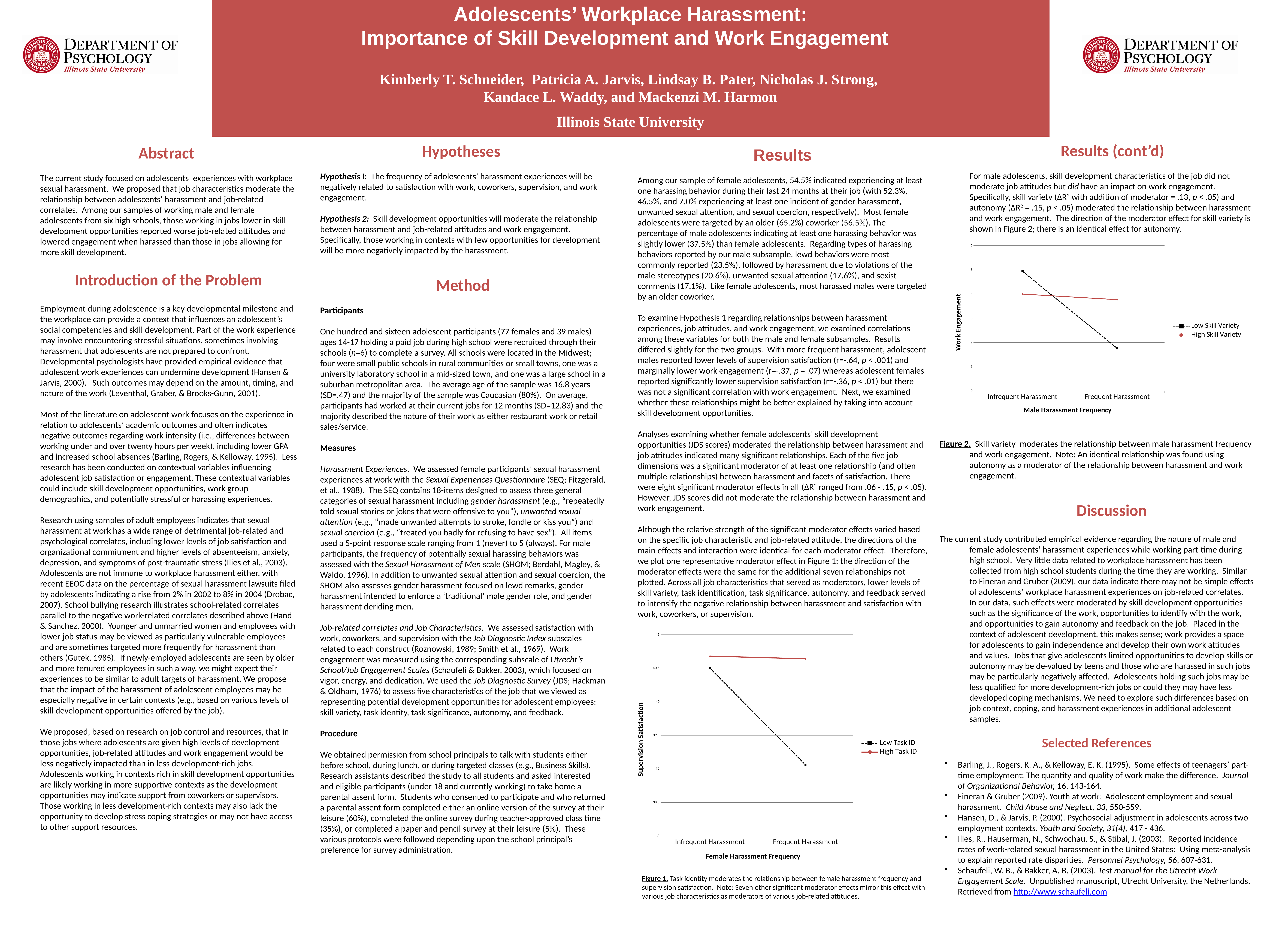
In Figure 1 (Supervision Satisfaction chart), which series has the higher value at Frequent Harassment, Low Task ID or High Task ID? High Task ID In Figure 1 (Supervision Satisfaction chart), is the Low Task ID value at Frequent Harassment greater or less than 39.5? less In Figure 2 (Work Engagement chart), which series has the higher value at Infrequent Harassment, Low Skill Variety or High Skill Variety? Low Skill Variety In Figure 1 (Supervision Satisfaction chart), how many categories are on the x axis? 2 In Figure 2 (Work Engagement chart), how many series does the legend list? 2 In Figure 2 (Work Engagement chart), is the Low Skill Variety value at Frequent Harassment greater or less than 3? less In Figure 1 (Supervision Satisfaction chart), what are the two series named in the legend? Low Task ID and High Task ID In Figure 1 (Supervision Satisfaction chart), does the Low Task ID line rise or fall from Infrequent Harassment to Frequent Harassment? fall In Figure 2 (Work Engagement chart), does the Low Skill Variety line rise or fall from Infrequent Harassment to Frequent Harassment? fall In Figure 2 (Work Engagement chart), what is the title of the x axis? Male Harassment Frequency In Figure 1 (Supervision Satisfaction chart), what kind of chart is shown? line chart In Figure 1 (Supervision Satisfaction chart), how many series does the legend list? 2